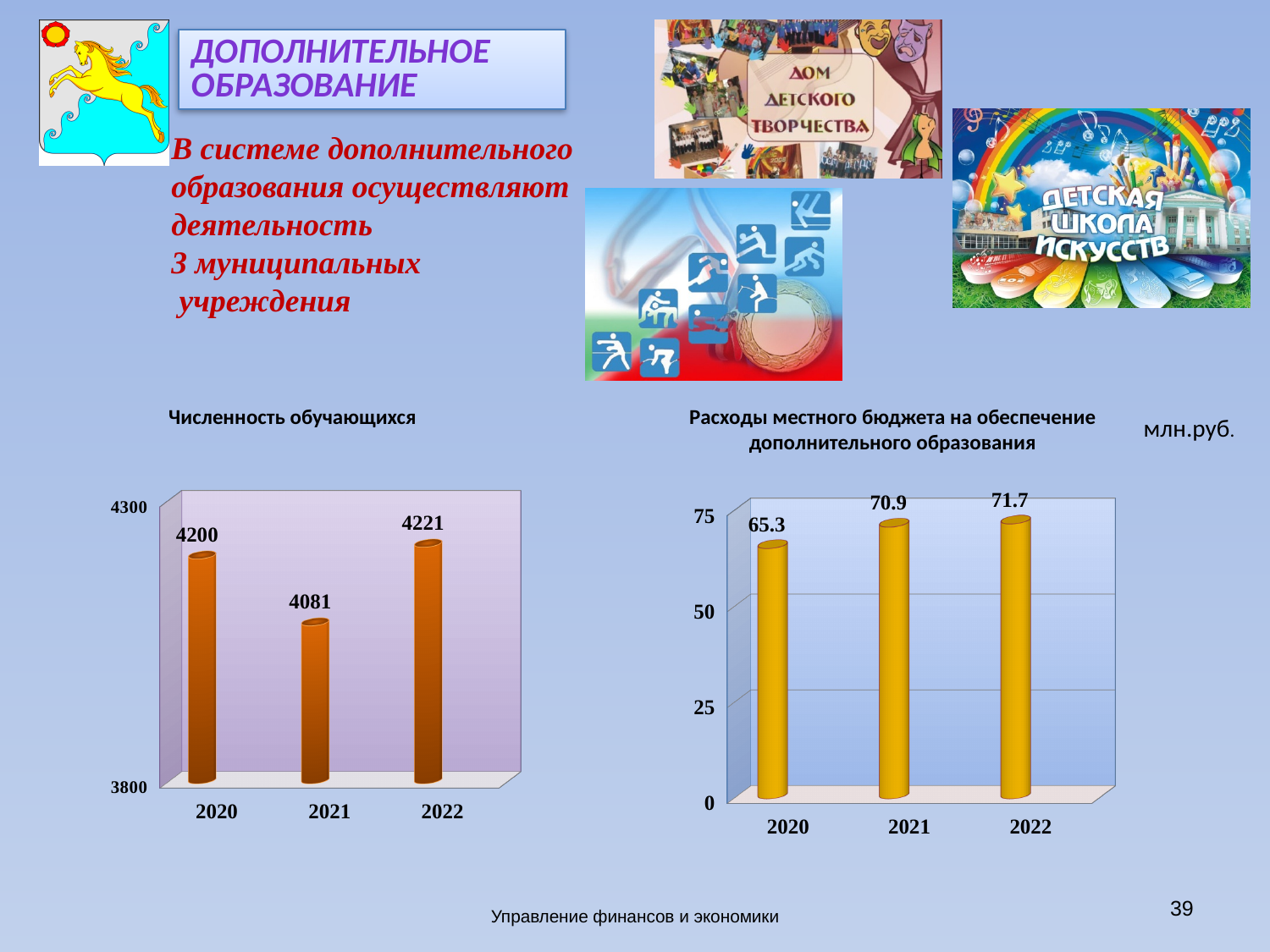
In the 'Расходы местного бюджета на обеспечение дополнительного образования' chart, what is the difference between the values for 2021 and 2020? 5.6 In the 'Расходы местного бюджета на обеспечение дополнительного образования' chart, what is the value for 2020? 65.3 In the 'Расходы местного бюджета на обеспечение дополнительного образования' chart, which year has the lowest value? 2020 In the 'Численность обучающихся' chart, how many years are shown on the x axis? 3 In the 'Расходы местного бюджета на обеспечение дополнительного образования' chart, is the value for 2021 greater or less than 50? greater In the 'Численность обучающихся' chart, what is the value for 2021? 4081 In the 'Численность обучающихся' chart, which year has the lowest value? 2021 What kind of chart is the 'Численность обучающихся' chart? bar chart In the 'Расходы местного бюджета на обеспечение дополнительного образования' chart, do the values rise or fall from 2020 to 2022? rise In the 'Численность обучающихся' chart, what is the difference between the values for 2022 and 2020? 21 In the 'Численность обучающихся' chart, which year has the highest value? 2022 In the 'Расходы местного бюджета на обеспечение дополнительного образования' chart, what is the value for 2022? 71.7